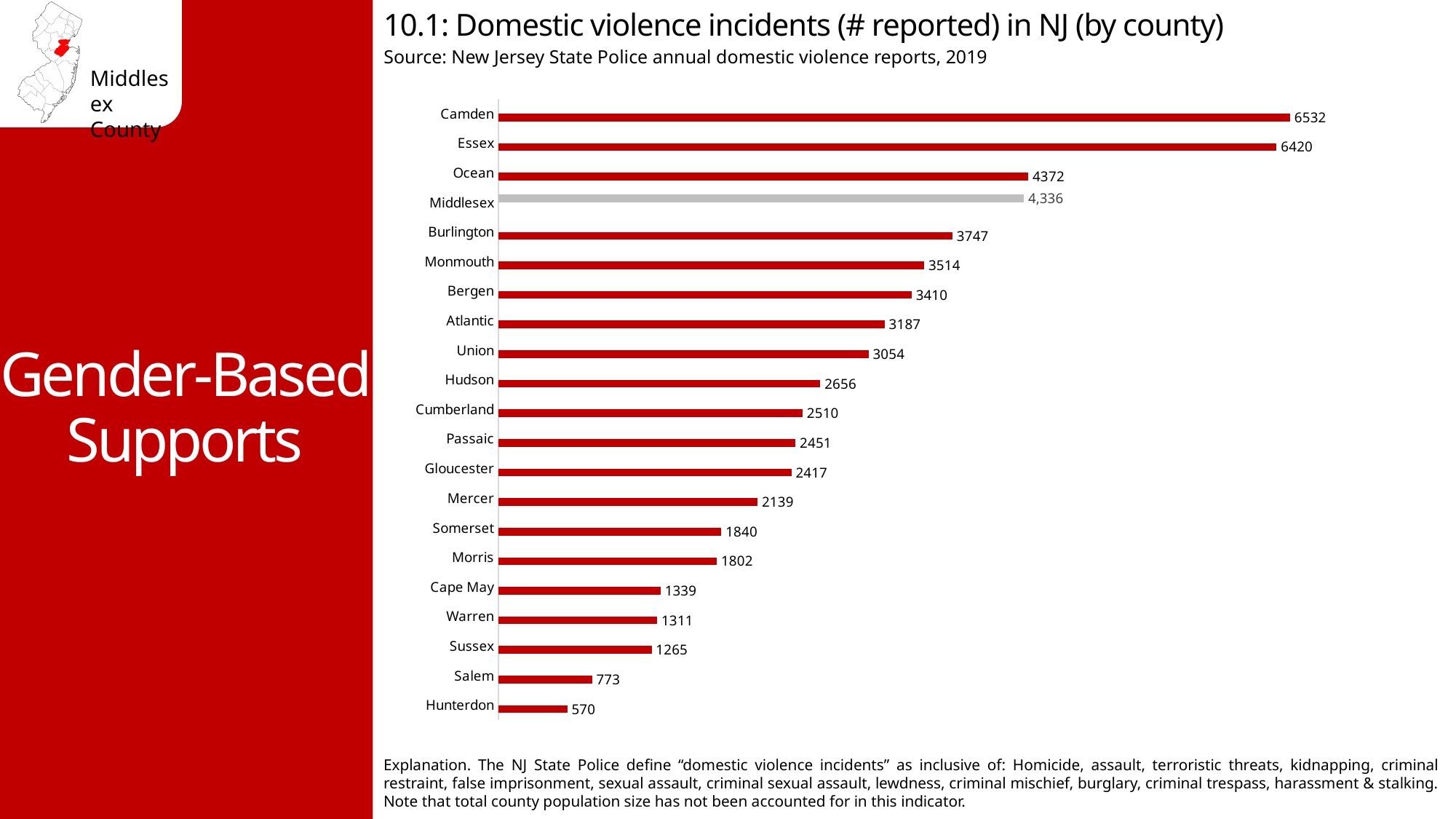
Which county has more reported incidents, Bergen or Atlantic? Bergen Which county's bar is shown in grey rather than red? Middlesex What is the difference between the values for Camden and Essex? 112 What type of chart is used on this slide? Bar chart How many counties are shown in the chart? 21 Which county has more reported incidents, Salem or Sussex? Sussex What is the value shown for Hudson County? 2656 What is the difference between the values for Ocean and Middlesex? 36 Which county has the highest number of reported domestic violence incidents? Camden How many domestic violence incidents were reported in Middlesex County? 4,336 How many domestic violence incidents were reported in Camden County? 6532 Which county has the lowest number of reported domestic violence incidents? Hunterdon